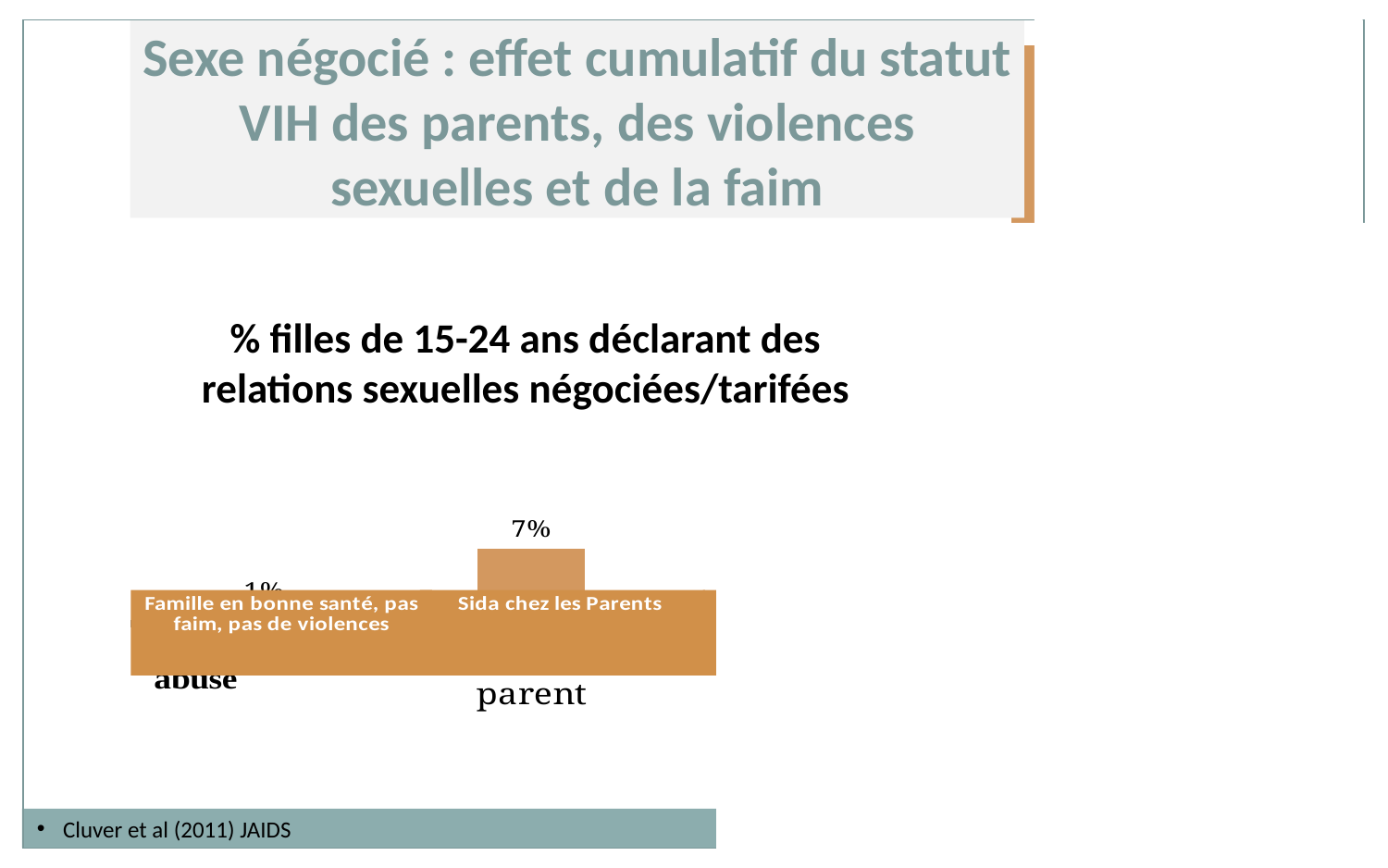
Which is larger: the value for "Sida chez les Parents" or the value for "Famille en bonne santé, pas faim, pas de violences"? Sida chez les Parents Do the values rise or fall from the left category to the right category? Rise Which category has the highest value? Sida chez les Parents What kind of chart is shown on the slide? Bar chart What is the title of the chart? % filles de 15-24 ans déclarant des relations sexuelles négociées/tarifées What is the value for "Famille en bonne santé, pas faim, pas de violences"? 1% What is the source cited at the bottom of the slide? Cluver et al (2011) JAIDS Which category has the lowest value? Famille en bonne santé, pas faim, pas de violences What is the difference between the value for "Sida chez les Parents" and the value for "Famille en bonne santé, pas faim, pas de violences"? 6% What is the value for "Sida chez les Parents"? 7%